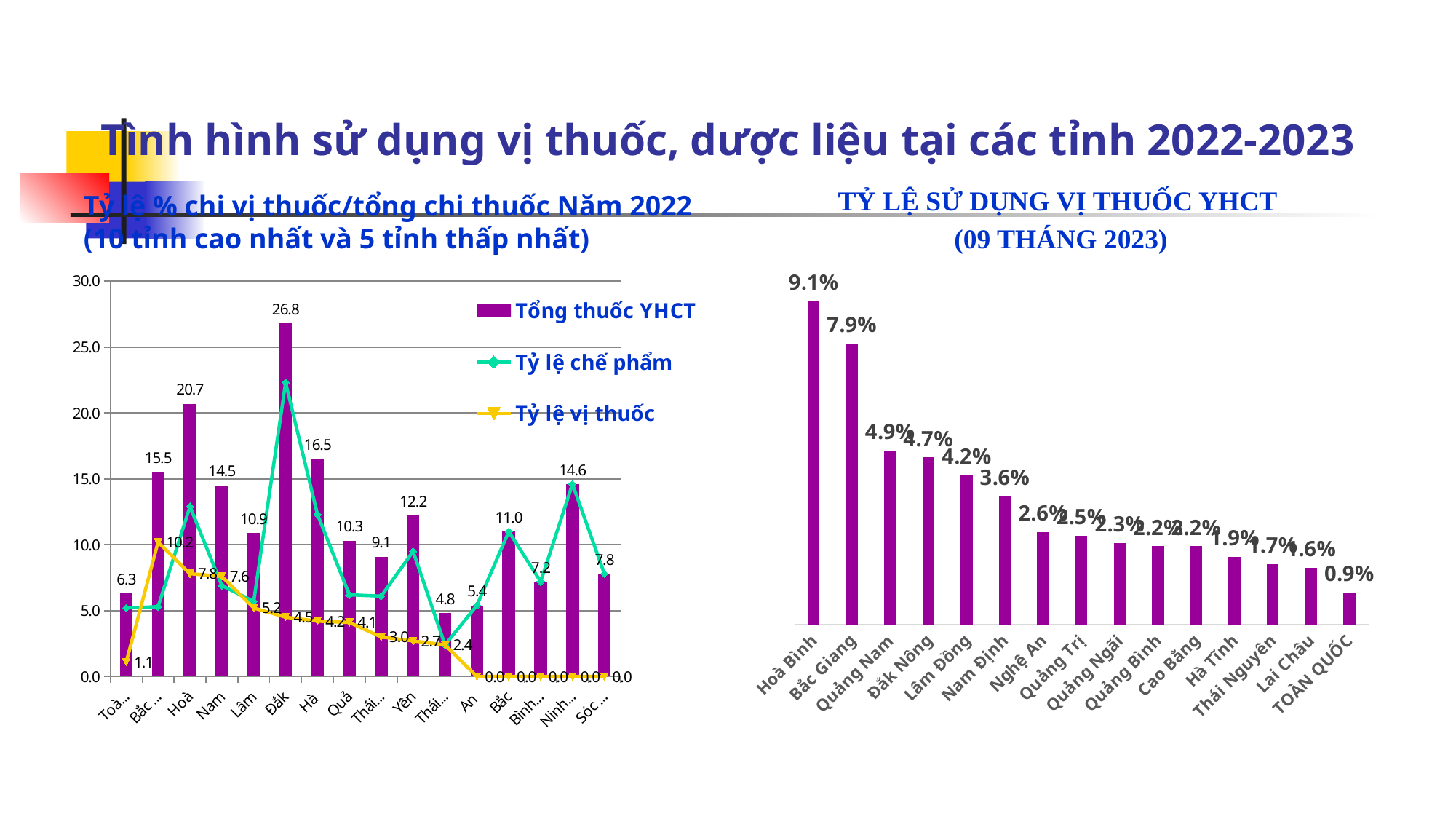
In the right chart (TỶ LỆ SỬ DỤNG VỊ THUỐC YHCT), what is the value for Lâm Đồng? 4.2% In the left chart (Tỷ lệ % chi vị thuốc/tổng chi thuốc Năm 2022), what is the highest Tổng thuốc YHCT bar value? 26.8 How many series does the legend of the left chart (Tỷ lệ % chi vị thuốc/tổng chi thuốc Năm 2022) list? 3 In the right chart (TỶ LỆ SỬ DỤNG VỊ THUỐC YHCT), which is larger, Quảng Nam or Nam Định? Quảng Nam What kind of chart is the right chart (TỶ LỆ SỬ DỤNG VỊ THUỐC YHCT)? bar chart In the right chart (TỶ LỆ SỬ DỤNG VỊ THUỐC YHCT), which category has the highest value? Hoà Bình In the right chart (TỶ LỆ SỬ DỤNG VỊ THUỐC YHCT), do the values rise or fall from left to right? fall In the left chart (Tỷ lệ % chi vị thuốc/tổng chi thuốc Năm 2022), which series is drawn as bars? Tổng thuốc YHCT In the right chart (TỶ LỆ SỬ DỤNG VỊ THUỐC YHCT), what is the value for Hoà Bình? 9.1% How many categories are shown in the right chart (TỶ LỆ SỬ DỤNG VỊ THUỐC YHCT)? 15 In the right chart (TỶ LỆ SỬ DỤNG VỊ THUỐC YHCT), which category has the lowest value? TOÀN QUỐC In the right chart (TỶ LỆ SỬ DỤNG VỊ THUỐC YHCT), what is the difference between Hoà Bình and Bắc Giang? 1.2%